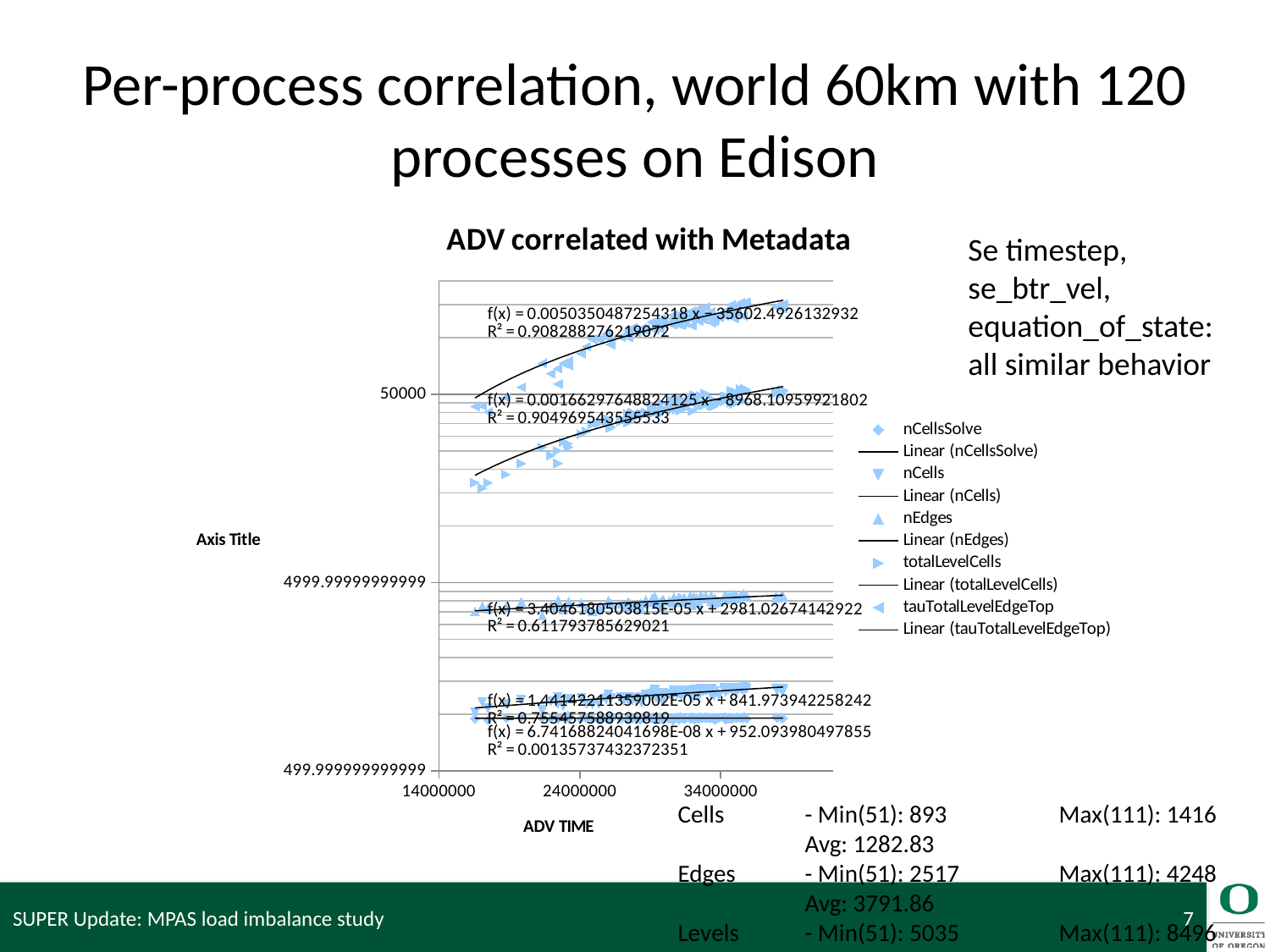
Do the plotted values generally rise or fall as ADV TIME increases along the x axis? rise What is the largest tick label shown on the x axis? 34000000 How many entries does the chart's legend list? 10 How many data series (excluding the linear trendlines) does the legend list? 5 What is the title of the chart? ADV correlated with Metadata What is the x-axis title of the chart? ADV TIME How many tick labels are shown on the x axis of the chart? 3 What R² value is printed for the trendline with equation f(x) = 6.74168824041698E-08 x + 952.093980497855? 0.00135737432372351 What R² value is printed for the trendline with equation f(x) = 3.40461805038815E-05 x + 2981.02674142922? 0.611793785629021 What R² value is printed for the trendline with equation f(x) = 0.0050350487254318 x − 35602.4926132932? 0.908288276219072 What kind of chart is shown on the slide? scatter chart What R² value is printed for the trendline with equation f(x) = 0.00166297648824125 x − 8968.10959921802? 0.904969543555533